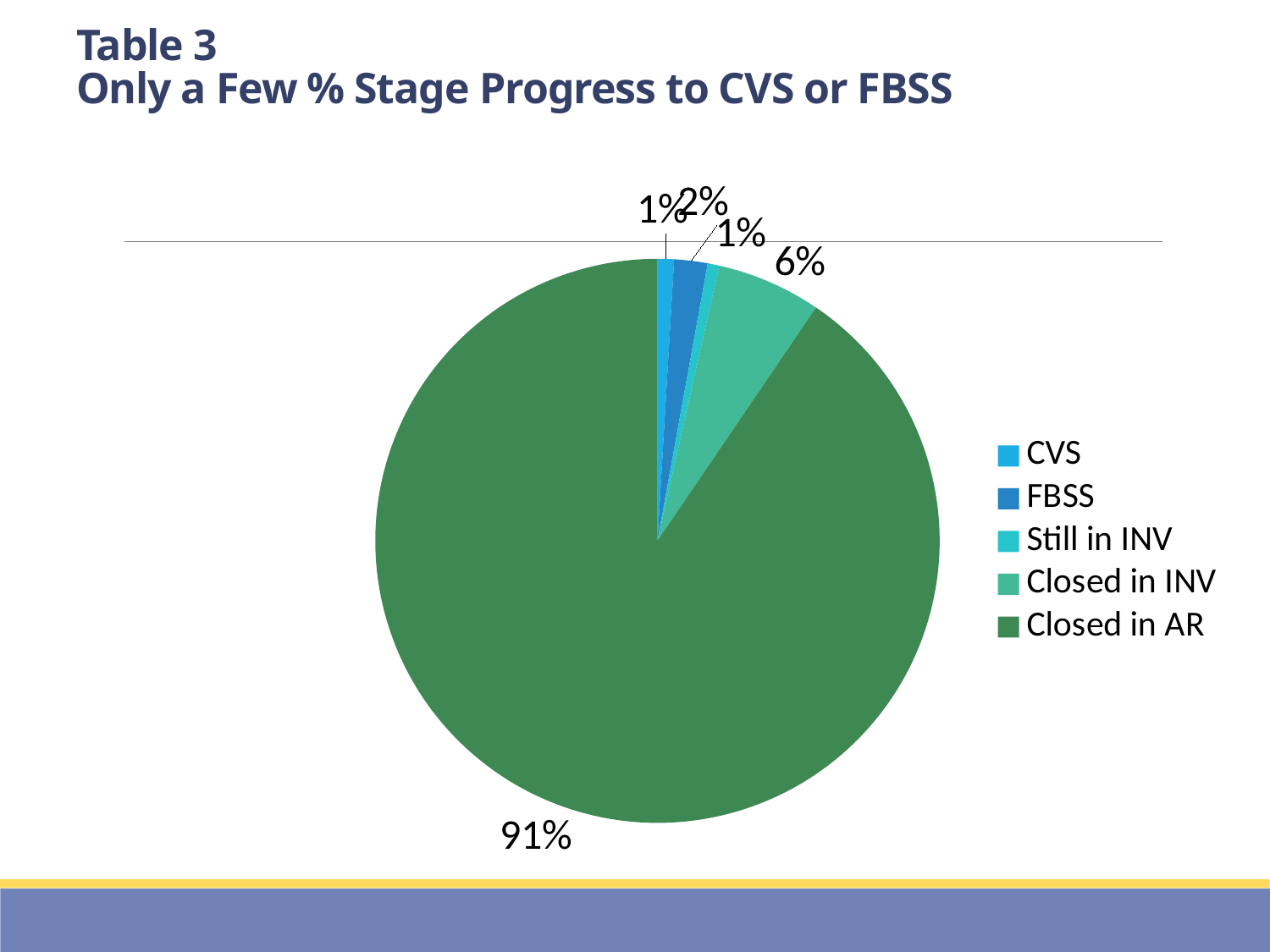
Which is larger, the slice for Closed in INV or the slice for FBSS? Closed in INV What share of the pie is CVS? 1% What is the title of the chart on the slide? Table 3 Only a Few % Stage Progress to CVS or FBSS What share of the pie is Closed in INV? 6% What share of the pie is FBSS? 2% What is the difference in percentage points between the FBSS slice and the CVS slice? 1 How many categories does the legend list? 5 What is the difference in percentage points between the Closed in AR slice and the Closed in INV slice? 85 Which legend entry is shown in dark green? Closed in AR Which category has the largest slice of the pie? Closed in AR What type of chart is shown on the slide? pie chart